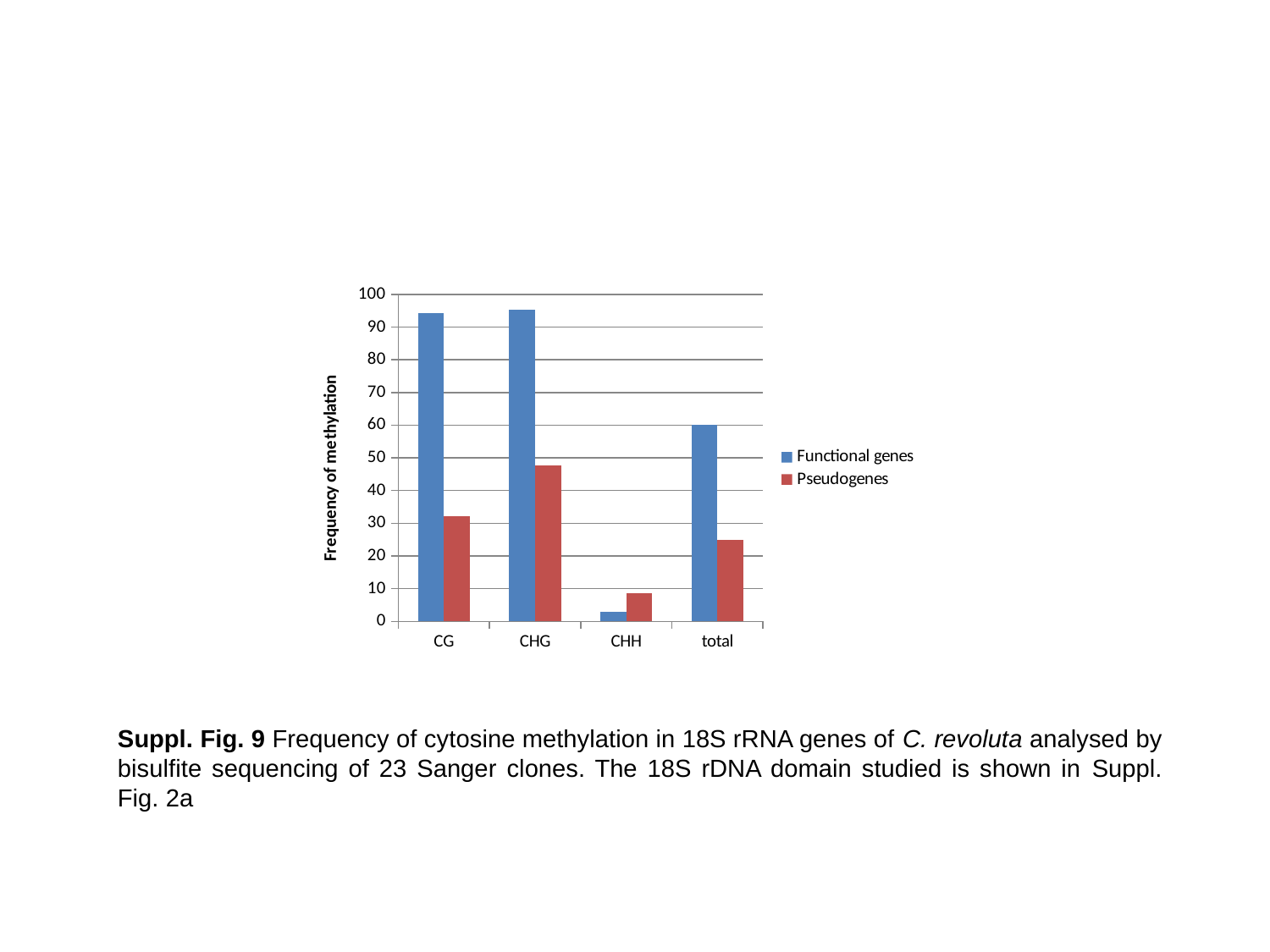
Which category has the highest value for Pseudogenes? CHG What is the label of the y axis? Frequency of methylation Which category has the lowest value for Pseudogenes? CHH Is the value for Pseudogenes at total greater or less than 30? less Is the value for Pseudogenes at CG greater or less than 40? less How many categories are shown on the x axis? 4 For the total category, which series has the larger value, Functional genes or Pseudogenes? Functional genes For the CHH category, which series has the larger value, Functional genes or Pseudogenes? Pseudogenes What kind of chart is shown on the slide? bar chart Which category has the lowest value for Functional genes? CHH Is the value for Functional genes at CG greater or less than 90? greater How many series does the legend list? 2